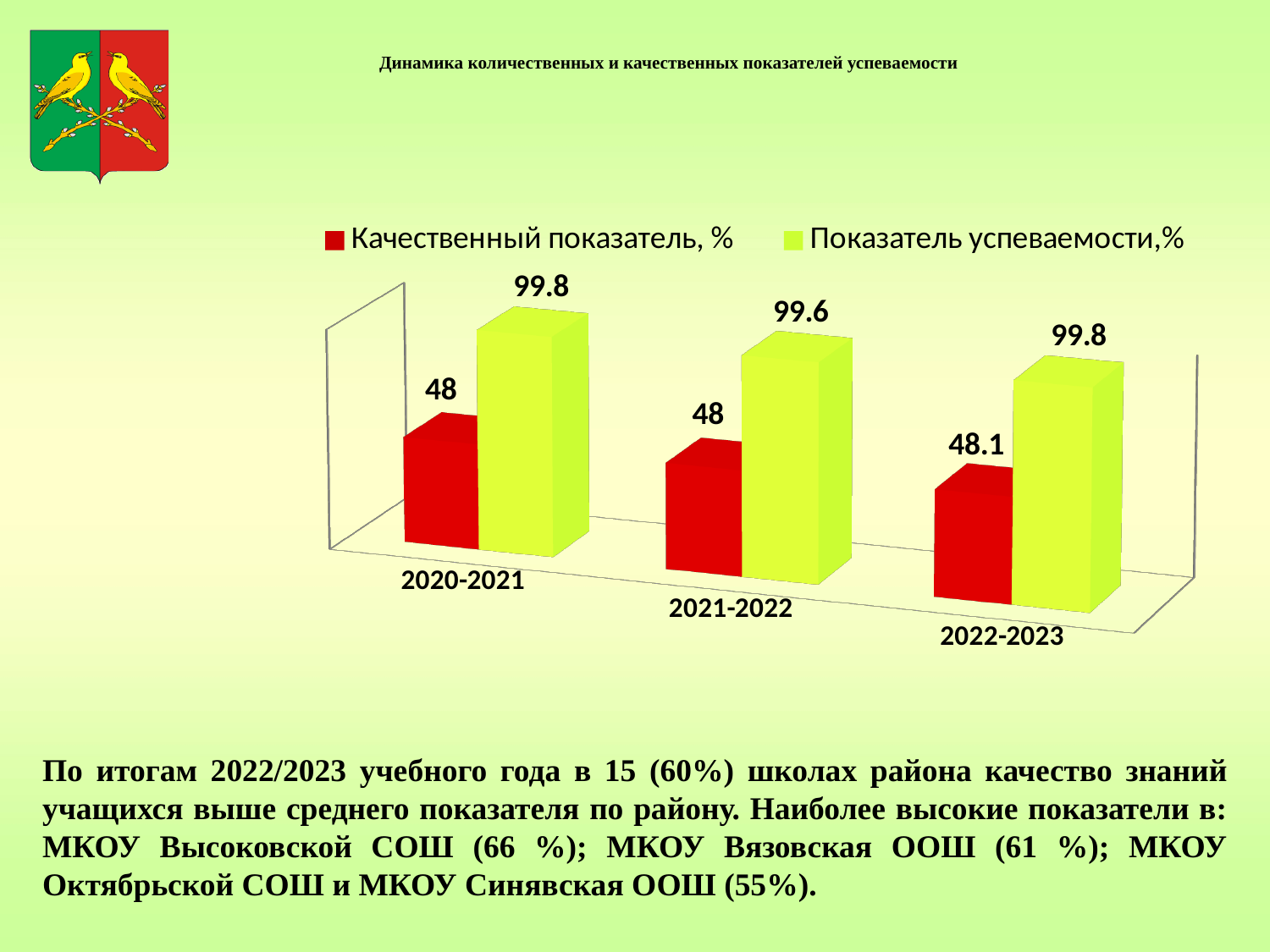
In which year is Качественный показатель, % the highest? 2022-2023 Which is larger for 2021-2022: Качественный показатель, % or Показатель успеваемости,%? Показатель успеваемости,% What is the value of Показатель успеваемости,% for 2022-2023? 99.8 How many year categories are shown on the chart? 3 What kind of chart is shown on the slide? Bar chart What is the value of Качественный показатель, % for 2020-2021? 48 What is the value of Качественный показатель, % for 2022-2023? 48.1 In which year is Показатель успеваемости,% the lowest? 2021-2022 What is the difference between Показатель успеваемости,% and Качественный показатель, % for 2022-2023? 51.7 How many series does the legend list? 2 What is the difference between Показатель успеваемости,% and Качественный показатель, % for 2020-2021? 51.8 What is the value of Показатель успеваемости,% for 2021-2022? 99.6